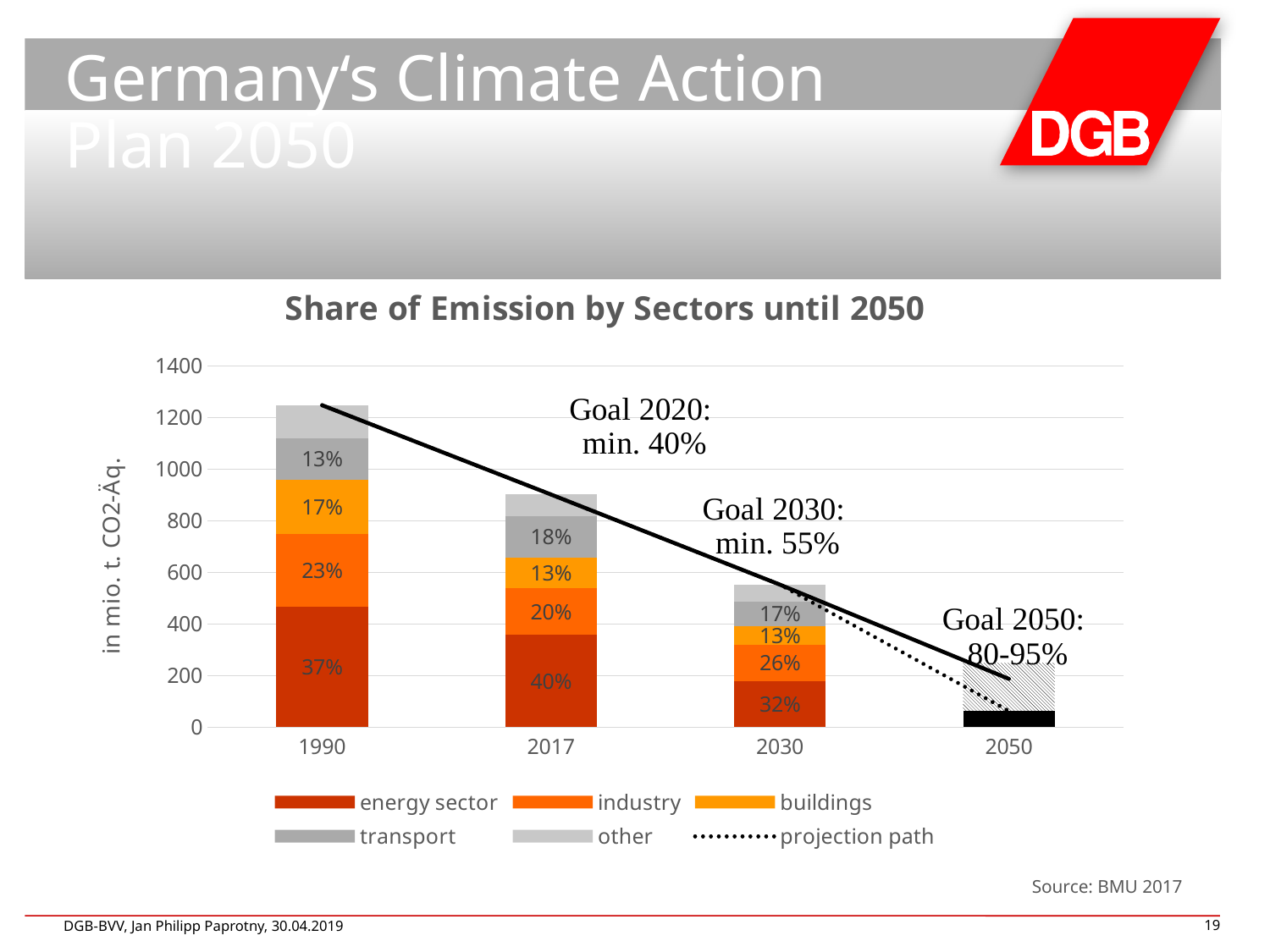
How many years are shown on the x axis of the chart? 4 What is the title of the chart? Share of Emission by Sectors until 2050 Is the total emissions bar for 1990 greater or less than 1200? greater What is the difference between the industry share in 2030 and the industry share in 2017? 6% What share of emissions does the energy sector have in 2017? 40% What kind of chart is shown on the slide? stacked bar chart with a projection line How many entries does the chart's legend list? 6 What share of emissions does industry have in 2030? 26% What share of emissions does the energy sector have in 1990? 37% What share of emissions does transport have in 2017? 18% Which sector has the largest share of emissions in 2030? energy sector Is the total emissions bar for 2030 greater or less than 600? less